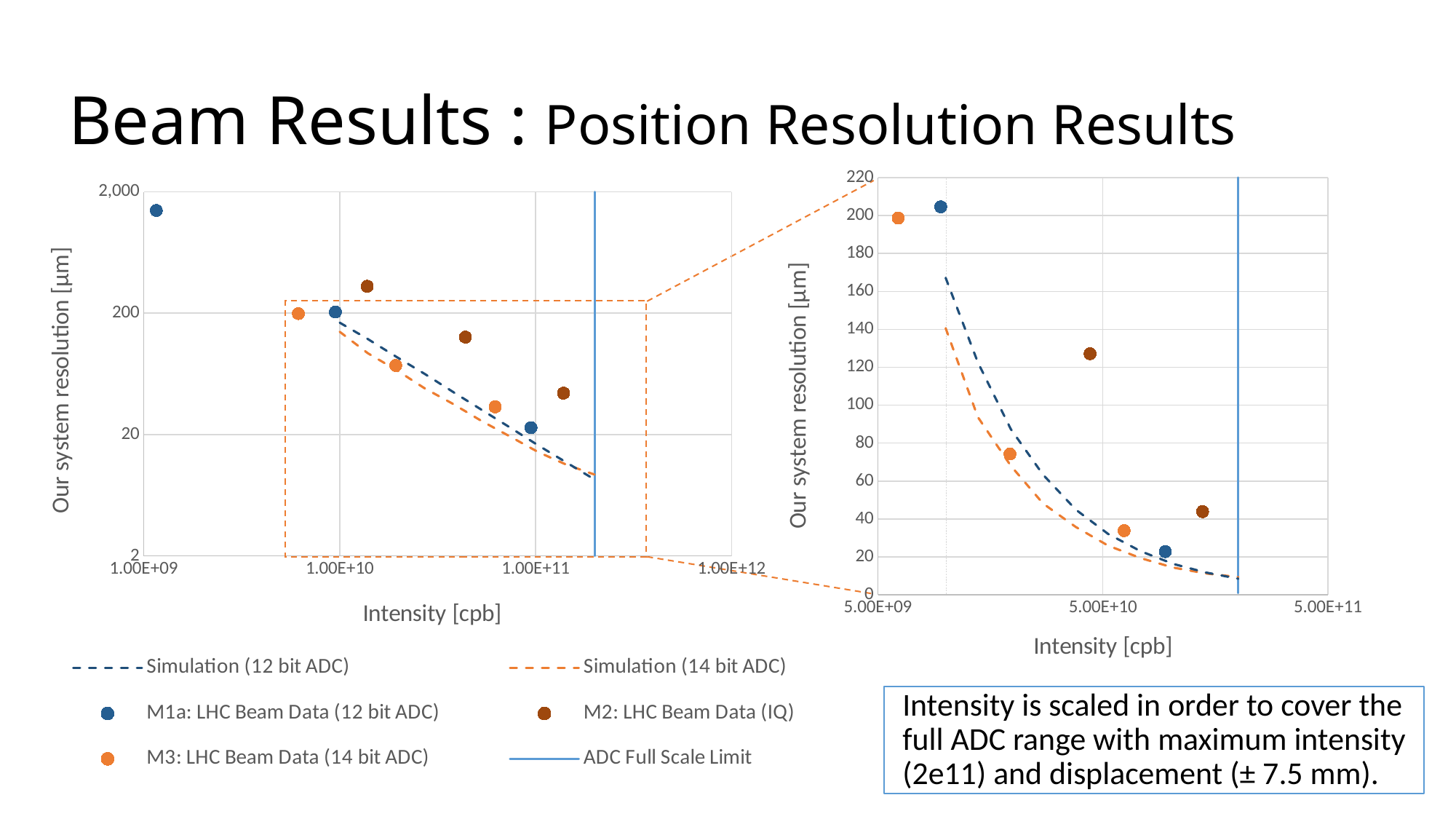
What is the x-axis label of the right chart? Intensity [cpb] In the right chart, how many M2: LHC Beam Data (IQ) points are plotted? 2 In the right chart, near 5.00E+10 intensity, which is larger: the M2: LHC Beam Data (IQ) point or the M3: LHC Beam Data (14 bit ADC) point? M2: LHC Beam Data (IQ) In the right chart, how many M3: LHC Beam Data (14 bit ADC) points are plotted? 3 What kind of chart is the left chart on the slide? scatter chart In the left chart, is the leftmost M1a: LHC Beam Data (12 bit ADC) point greater or less than 200? greater In the right chart, is the middle M3: LHC Beam Data (14 bit ADC) point greater or less than 80? less What is the y-axis label of the left chart? Our system resolution [µm] In the left chart, how many M1a: LHC Beam Data (12 bit ADC) points are plotted? 3 In the right chart, do the plotted resolution values rise or fall as intensity increases along the x axis? fall In the right chart, is the M2: LHC Beam Data (IQ) point near 5.00E+10 greater or less than 100? greater How many entries does the legend list? 6